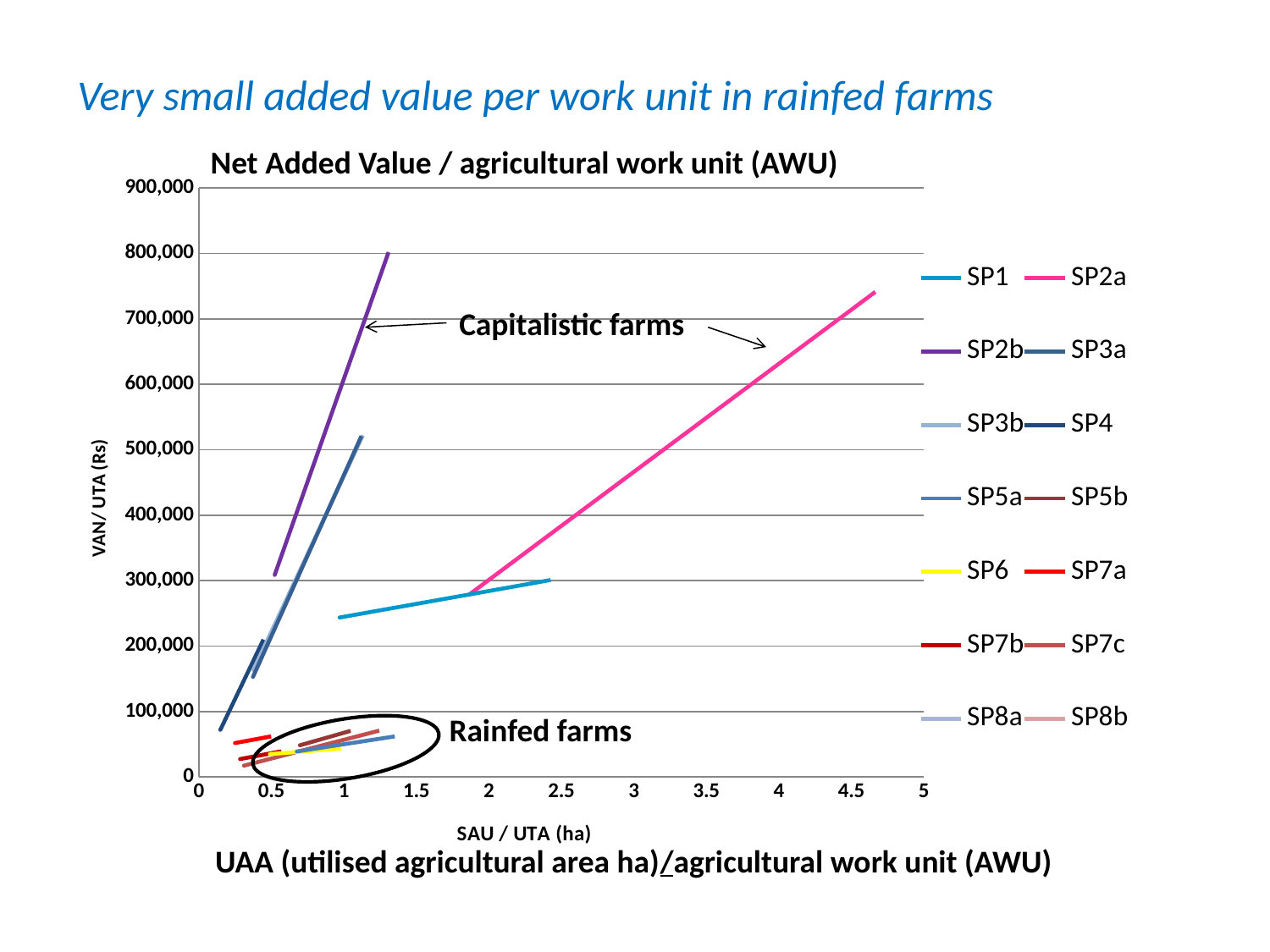
How many series does the legend list? 14 What is the label on the vertical axis of the chart? VAN/ UTA (Rs) Is the highest value reached by SP2a greater or less than 600,000? greater Which series extends furthest to the right along the horizontal axis? SP2a What is the title of the chart? Net Added Value / agricultural work unit (AWU) Which reaches a higher value on the vertical axis, SP2a or SP1? SP2a Are the values of SP6 greater or less than 100,000? less Does the SP2a line rise or fall as the value on the horizontal axis increases? rise Is the highest value reached by SP2b greater or less than 600,000? greater What kind of chart is shown on the slide? line chart Which series reaches the highest value on the vertical axis? SP2b